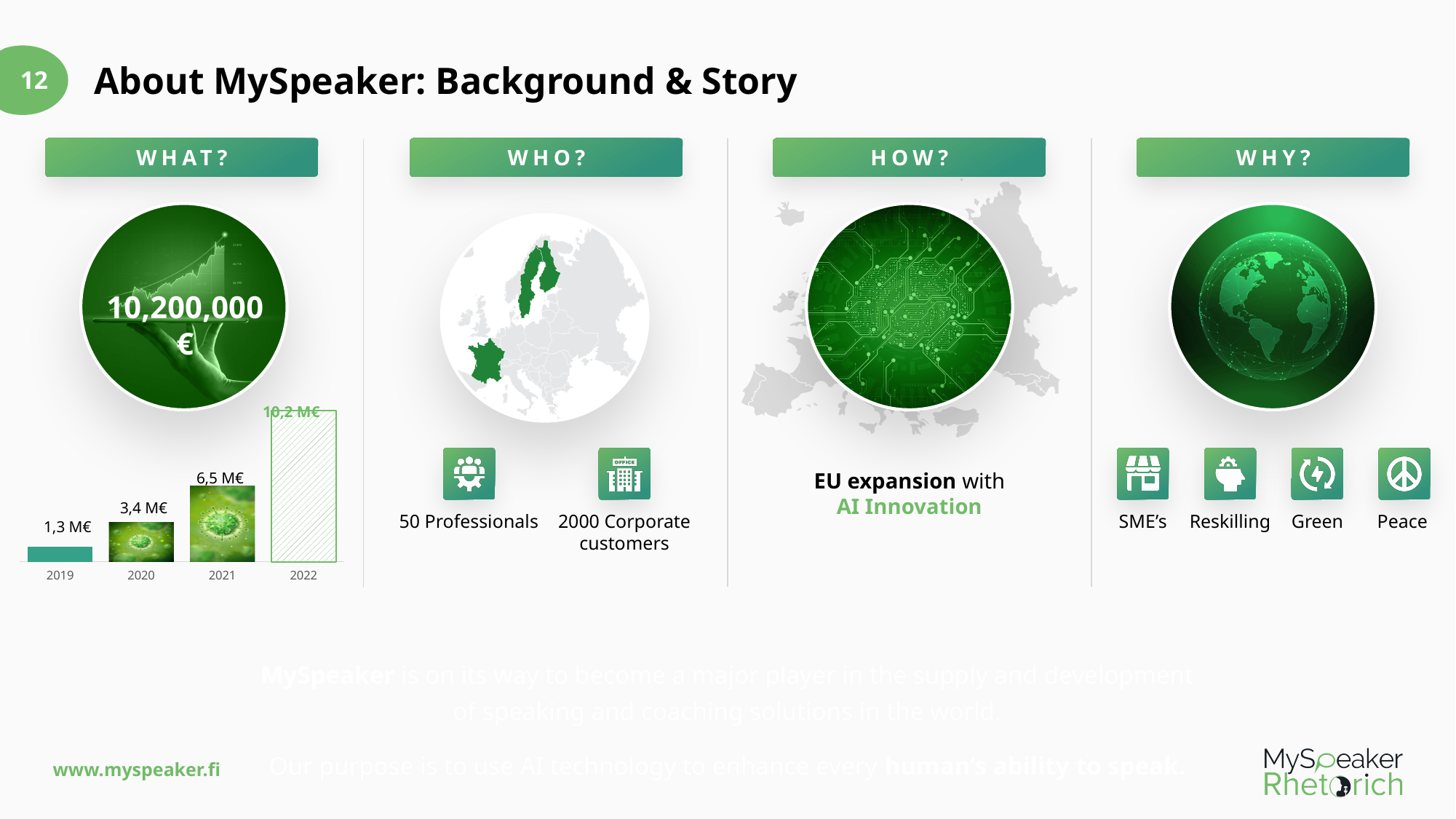
Which year has the lowest value in the bar chart? 2019 How many years are shown in the bar chart? 4 What is the value shown for 2021 in the bar chart? 6,5 M€ Which year has the highest value in the bar chart? 2022 What is the value shown for 2022 in the bar chart? 10,2 M€ Do the values in the bar chart rise or fall from 2019 to 2022? Rise What is the difference between the 2022 and 2021 values in the bar chart? 3,7 M€ What is the value shown for 2019 in the bar chart? 1,3 M€ What is the difference between the 2021 and 2020 values in the bar chart? 3,1 M€ What kind of chart is shown in the WHAT? section? Bar chart Which is larger in the bar chart, the value for 2020 or the value for 2021? 2021 What is the value shown for 2020 in the bar chart? 3,4 M€